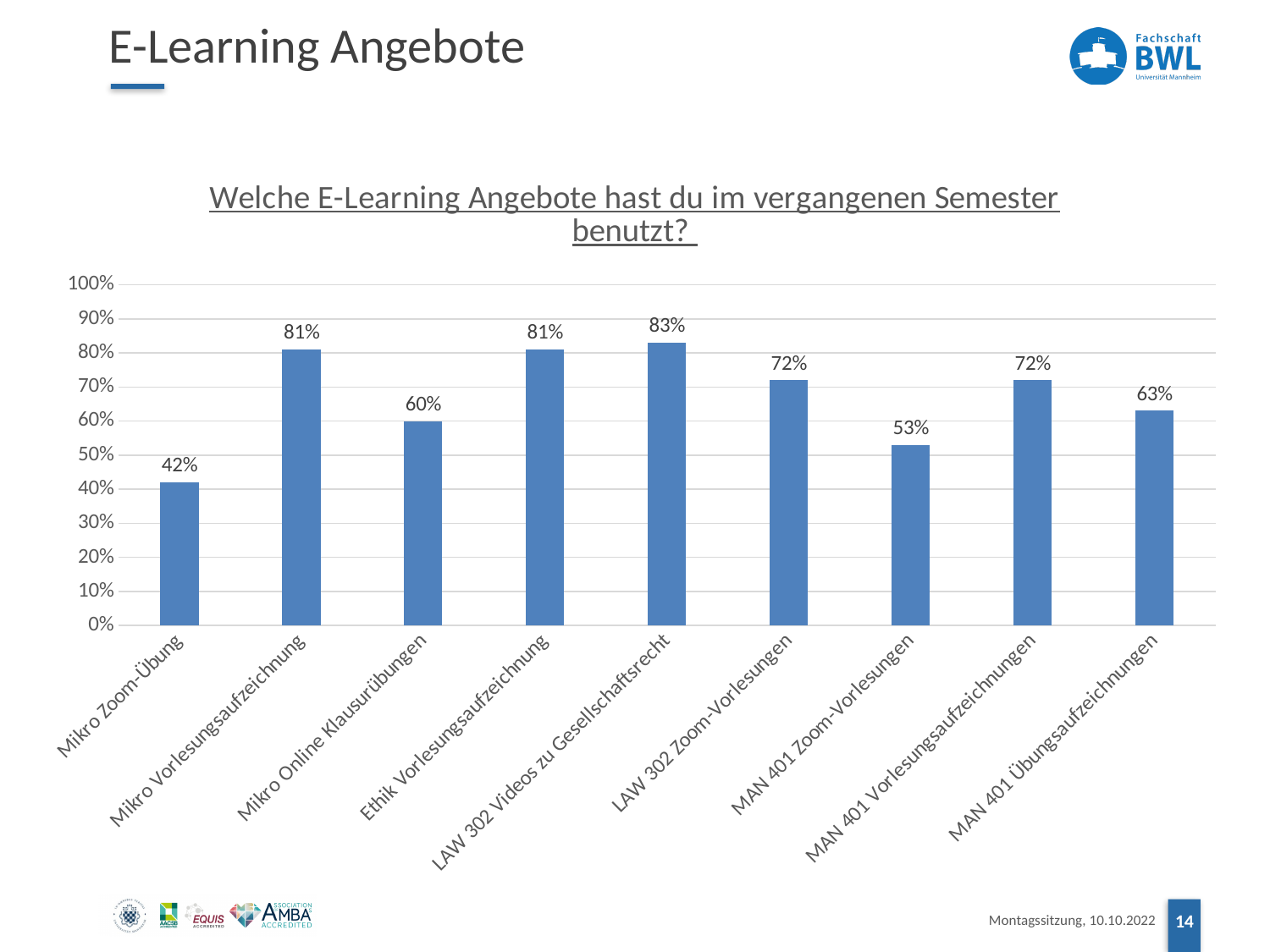
What is the value for MAN 401 Zoom-Vorlesungen? 53% How many categories are shown in the chart? 9 Which is larger, LAW 302 Zoom-Vorlesungen or MAN 401 Zoom-Vorlesungen? LAW 302 Zoom-Vorlesungen What kind of chart is shown on the slide? bar chart What is the value for Mikro Zoom-Übung? 42% What is the value for LAW 302 Videos zu Gesellschaftsrecht? 83% Which category has the highest value? LAW 302 Videos zu Gesellschaftsrecht Which category has the lowest value? Mikro Zoom-Übung What is the value for MAN 401 Übungsaufzeichnungen? 63% What is the difference between Mikro Vorlesungsaufzeichnung and Mikro Online Klausurübungen? 21% What is the title of the chart? Welche E-Learning Angebote hast du im vergangenen Semester benutzt? Is the value for Ethik Vorlesungsaufzeichnung greater or less than 70%? greater